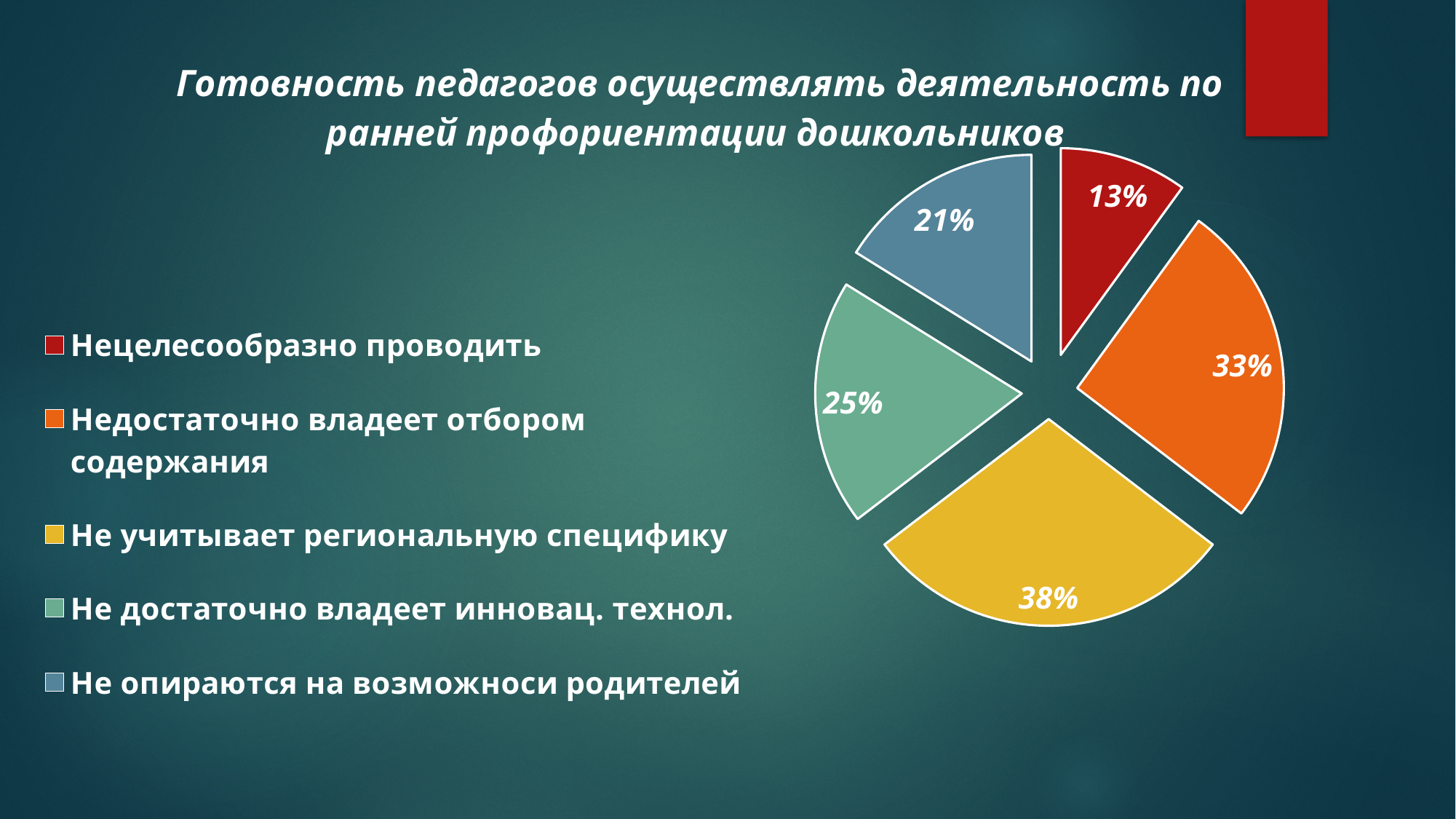
What percentage is shown for "Не опираются на возможноси родителей"? 21% Which category has the largest slice of the pie? Не учитывает региональную специфику What percentage is shown for "Не достаточно владеет инновац. технол."? 25% What kind of chart is shown on the slide? pie chart How many slices does the pie chart have? 5 What percentage is shown for "Нецелесообразно проводить"? 13% Which is larger: the slice for "Не достаточно владеет инновац. технол." or the slice for "Не опираются на возможноси родителей"? Не достаточно владеет инновац. технол. What percentage is shown for "Недостаточно владеет отбором содержания"? 33% Which category has the smallest slice of the pie? Нецелесообразно проводить What percentage is shown for "Не учитывает региональную специфику"? 38% What colour is the slice for "Недостаточно владеет отбором содержания"? orange What is the difference in percentage points between "Не учитывает региональную специфику" and "Нецелесообразно проводить"? 25